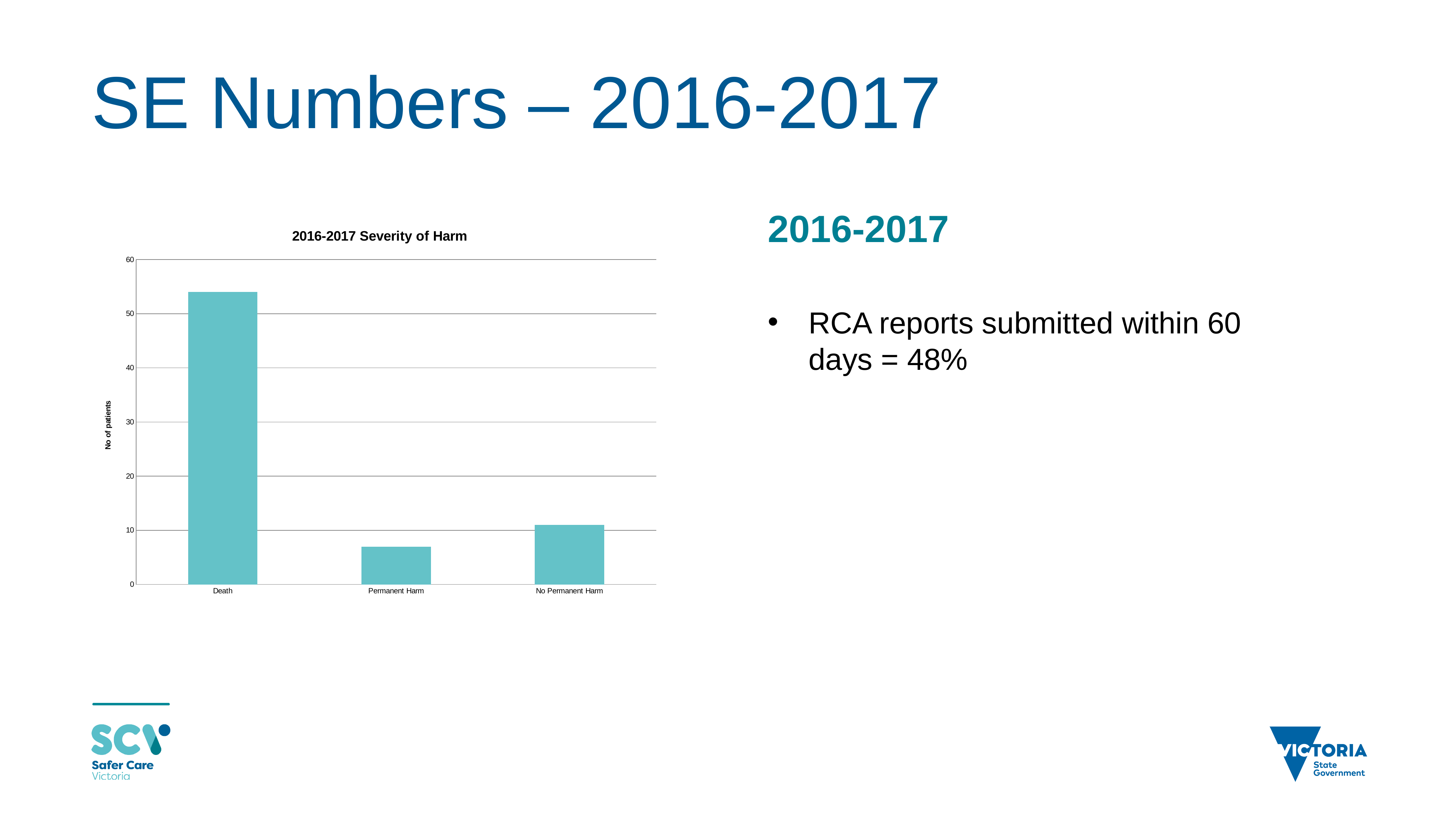
Is the value for Death greater or less than 50? greater What is the label of the vertical axis of the chart? No of patients Is the value for Permanent Harm greater or less than 10? less Is the value for Death greater or less than 60? less What is the title of the chart? 2016-2017 Severity of Harm How many categories are shown on the x axis of the chart? 3 Which category has the lowest number of patients? Permanent Harm What kind of chart is shown on the slide? bar chart Which category has the highest number of patients? Death Which is larger, the value for No Permanent Harm or the value for Permanent Harm? No Permanent Harm Does the value fall or rise from Death to Permanent Harm? fall